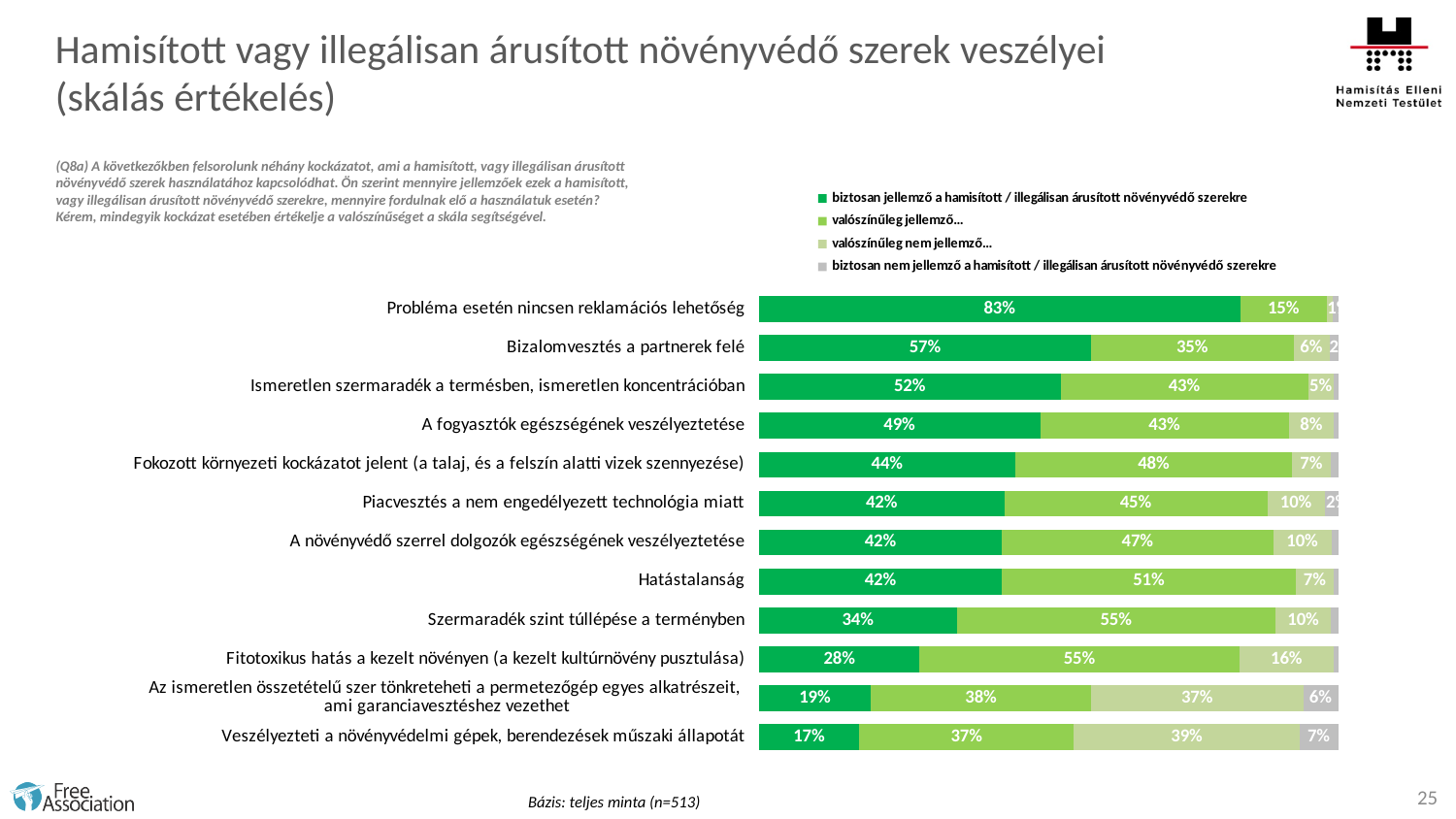
What is the 'valószínűleg jellemző' value for 'Hatástalanság'? 51% What is the 'valószínűleg nem jellemző' value for 'Veszélyezteti a növényvédelmi gépek, berendezések műszaki állapotát'? 39% What is the 'biztosan jellemző' value for 'Probléma esetén nincsen reklamációs lehetőség'? 83% How many categories (risks) are plotted in the chart? 12 What kind of chart is shown on the slide? Stacked bar chart How many series does the legend list? 4 What is the total of all four segments for 'Az ismeretlen összetételű szer tönkreteheti a permetezőgép egyes alkatrészeit, ami garanciavesztéshez vezethet'? 100% Which category has the highest 'biztosan jellemző' value? Probléma esetén nincsen reklamációs lehetőség What is the difference between the 'biztosan jellemző' values for 'Bizalomvesztés a partnerek felé' and 'Szermaradék szint túllépése a terményben'? 23% What is the 'valószínűleg nem jellemző' value for 'Fitotoxikus hatás a kezelt növényen'? 16% Which is larger: the 'valószínűleg jellemző' value for 'Fokozott környezeti kockázatot jelent' or for 'A fogyasztók egészségének veszélyeztetése'? Fokozott környezeti kockázatot jelent Which category has the lowest 'biztosan jellemző' value? Veszélyezteti a növényvédelmi gépek, berendezések műszaki állapotát